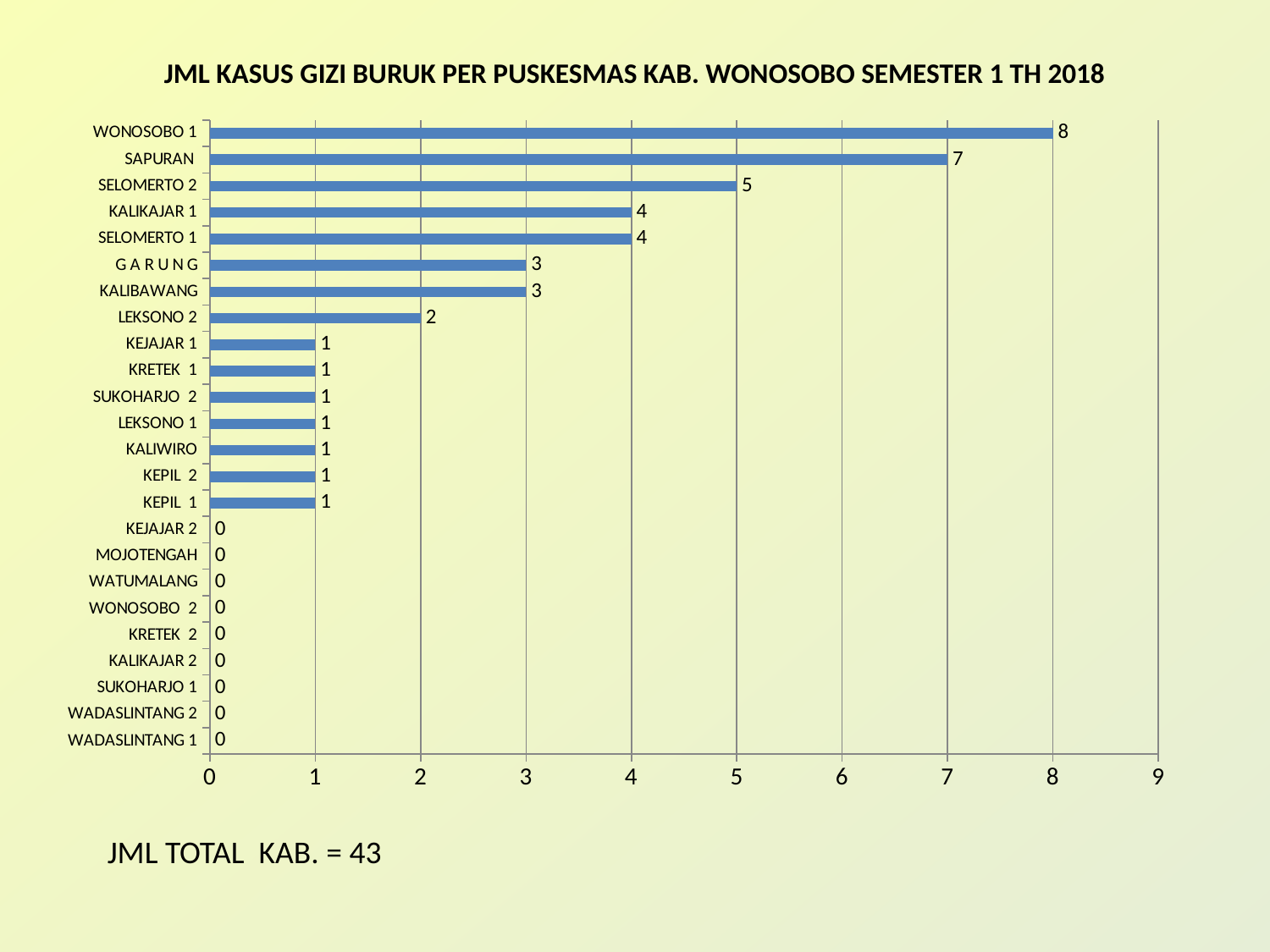
What is the value for KALIWIRO? 1 What is the difference between the values for WONOSOBO 1 and SAPURAN? 1 Which is larger, the value for KALIKAJAR 1 or the value for KALIBAWANG? KALIKAJAR 1 Which puskesmas has the highest number of cases? WONOSOBO 1 What is the value for LEKSONO 2? 2 What is the value for SELOMERTO 2? 5 How many puskesmas categories are shown on the chart? 24 What is the value for SAPURAN? 7 How many puskesmas have a value of 0? 9 What kind of chart is shown on the slide? Bar chart What is the difference between the values for SELOMERTO 2 and G A R U N G? 2 What is the title of the chart? JML KASUS GIZI BURUK PER PUSKESMAS KAB. WONOSOBO SEMESTER 1 TH 2018